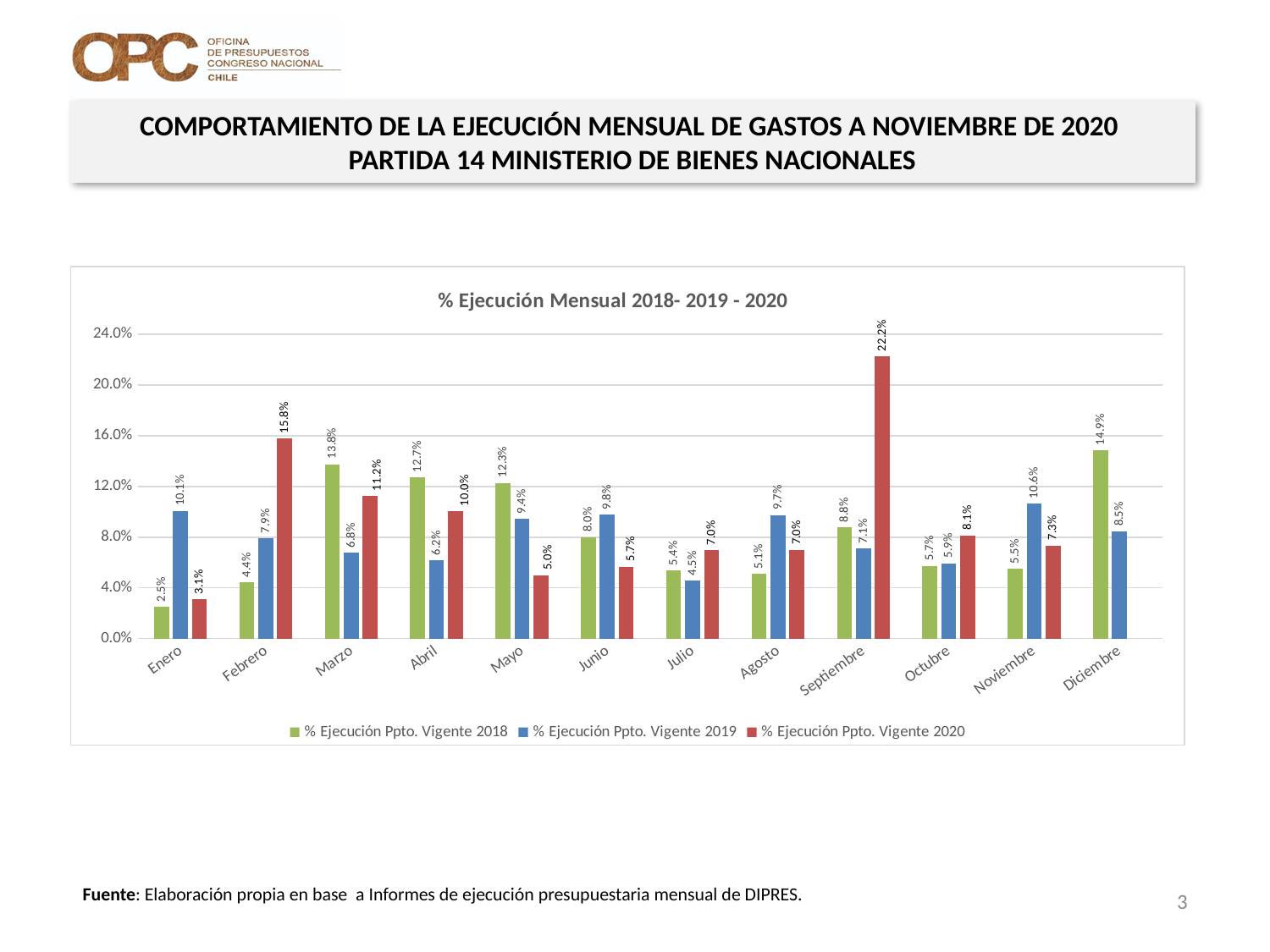
Is the value for % Ejecución Ppto. Vigente 2018 in Diciembre greater or less than 12.0%? greater What kind of chart is shown on the slide? Bar chart Which month has the lowest value for % Ejecución Ppto. Vigente 2018? Enero What is the title of the chart? % Ejecución Mensual 2018- 2019 - 2020 What is the value for % Ejecución Ppto. Vigente 2019 in Noviembre? 10.6% Which is larger in Mayo: the 2018 value or the 2019 value? 2018 Which month has the highest value for % Ejecución Ppto. Vigente 2020? Septiembre What is the value for % Ejecución Ppto. Vigente 2020 in Septiembre? 22.2% What is the value for % Ejecución Ppto. Vigente 2018 in Marzo? 13.8% How many months are shown on the x axis? 12 What is the difference between the 2020 and 2018 values in Febrero? 11.4% How many series does the legend list? 3